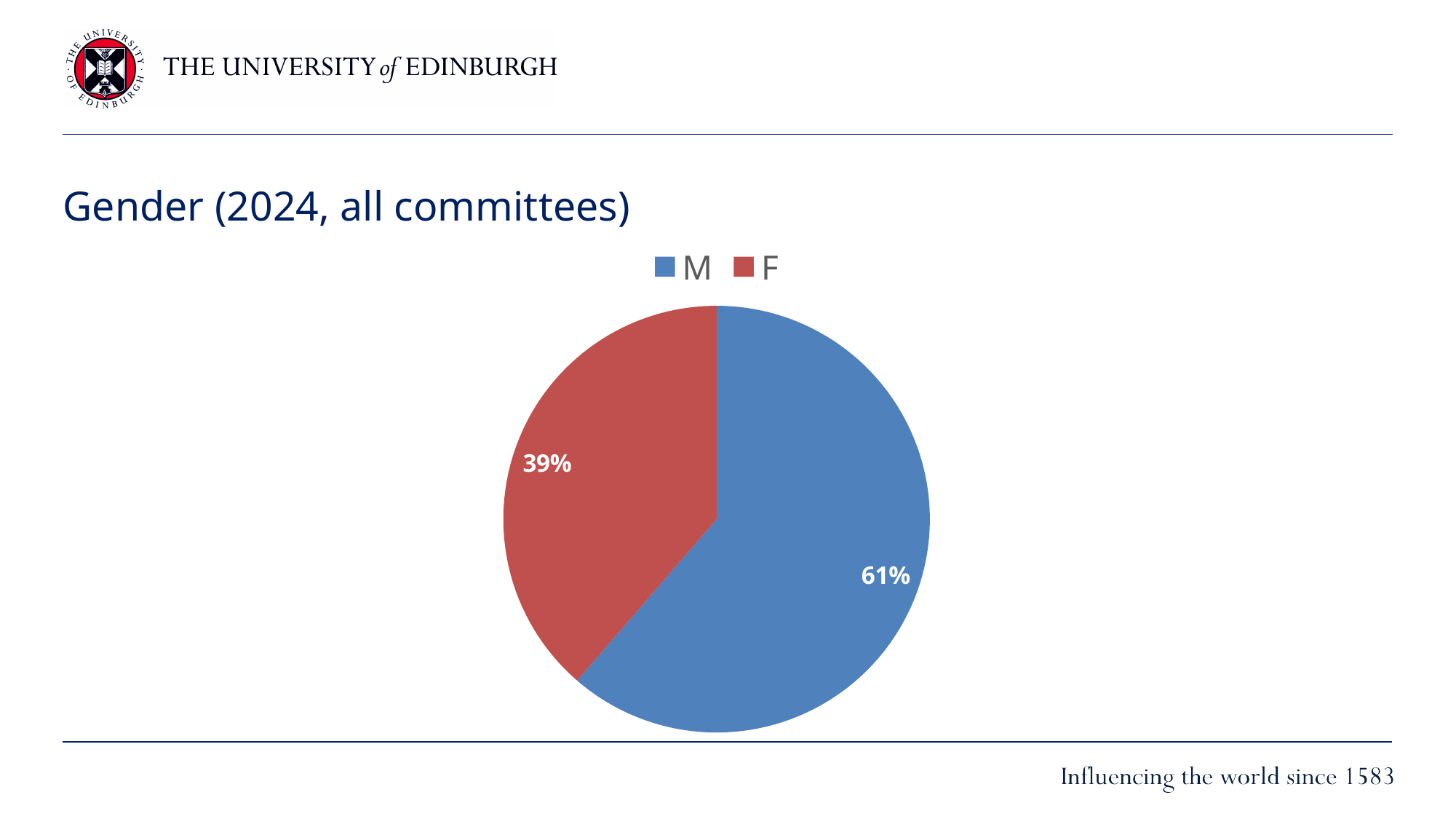
What kind of chart is shown on the slide? pie chart Which category has the smallest slice of the pie? F Which category has the largest slice of the pie? M What share of the pie is labelled F? 39% What is the difference in percentage points between the M and F slices? 22 How many entries does the legend list? 2 What colour is the slice for F? red What is the title of the slide's chart? Gender (2024, all committees) What share of the pie is labelled M? 61% How many slices does the pie chart have? 2 Which slice is larger, M or F? M